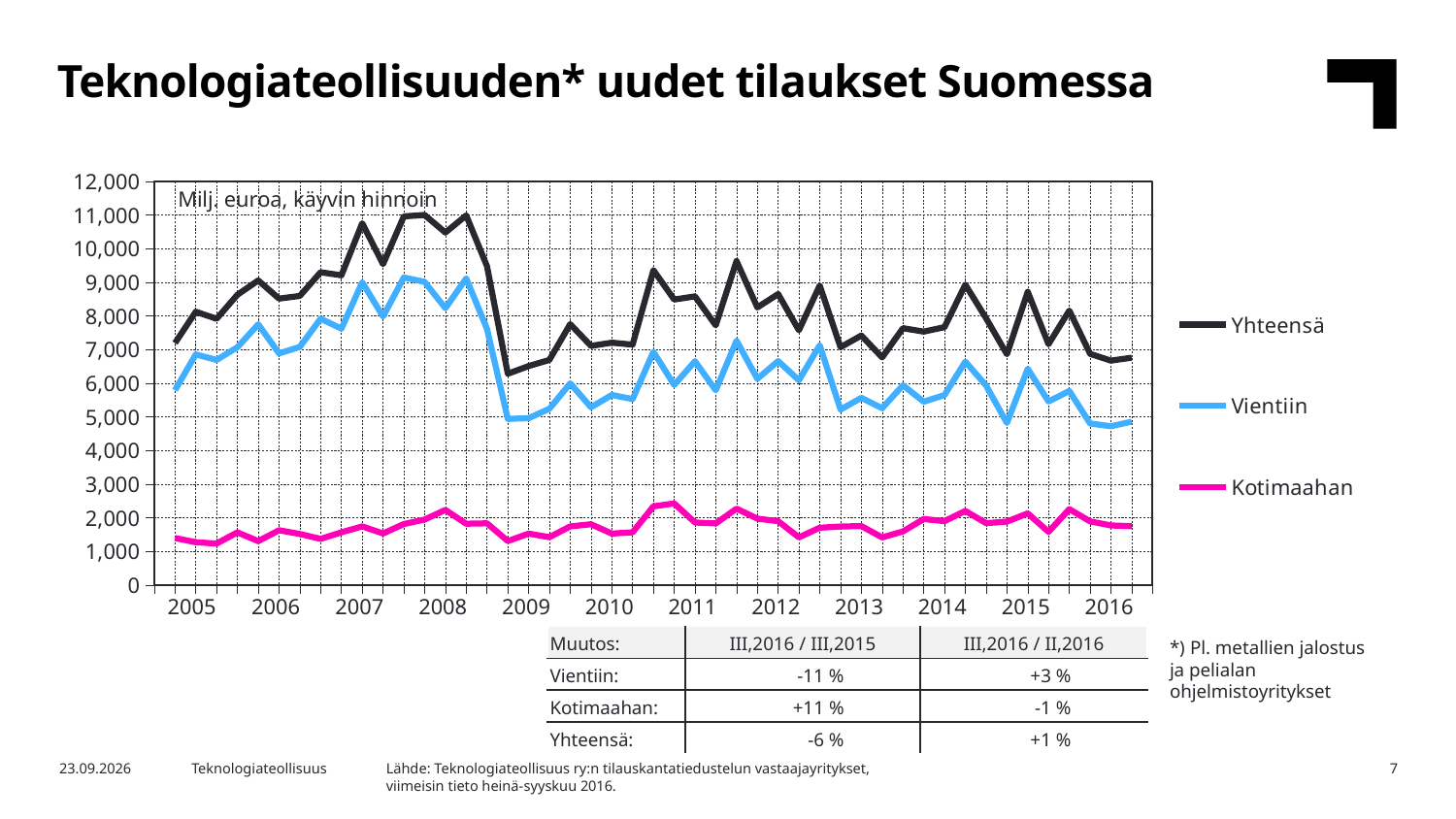
Which series is plotted with the black line? Yhteensä Does the Yhteensä line rise or fall between 2008 and 2009? fall Which series has the lowest values throughout the chart? Kotimaahan Is the peak value for Yhteensä in 2008 greater or less than 10,000? greater Is the value for Kotimaahan in 2010 greater or less than 3,000? less Is the value for Vientiin at the start of 2009 greater or less than 6,000? less Which series has the highest values throughout the chart? Yhteensä What kind of chart is shown on the slide? line chart What unit is stated in the label inside the chart area? Milj. euroa, käyvin hinnoin How many series does the legend list? 3 Which series is larger in 2012, Vientiin or Kotimaahan? Vientiin How many years are labelled on the x axis? 12